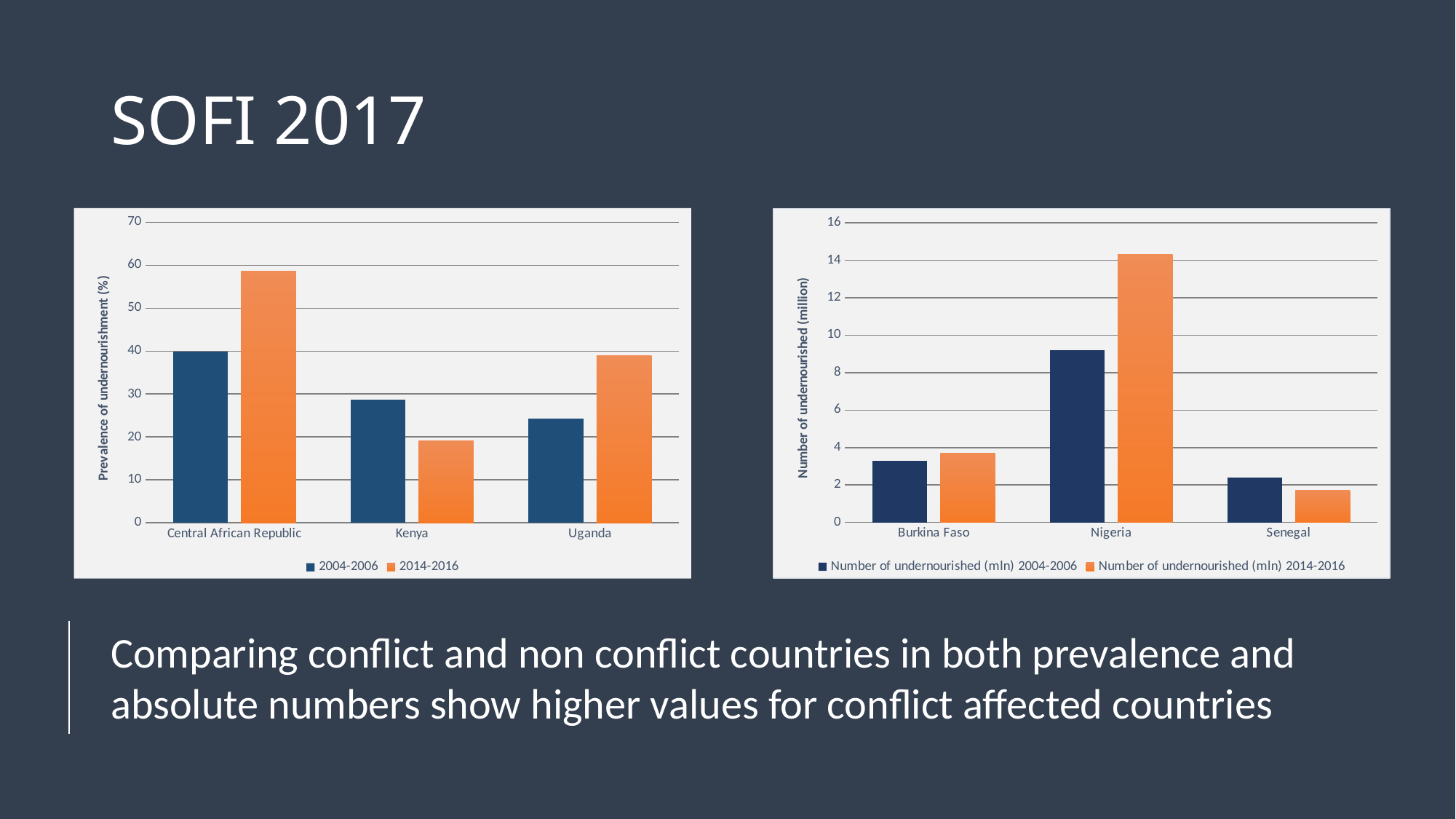
On the left chart (Prevalence of undernourishment), which country has the highest 2014-2016 value? Central African Republic What kind of chart is the left chart (Prevalence of undernourishment)? bar chart On the left chart (Prevalence of undernourishment), which is larger for Kenya: the 2004-2006 value or the 2014-2016 value? 2004-2006 On the right chart (Number of undernourished), which country has the highest 2014-2016 value? Nigeria How many countries are shown on the left chart (Prevalence of undernourishment)? 3 On the right chart (Number of undernourished), is the 2014-2016 value for Nigeria greater or less than 12? greater What is the y-axis label of the right chart? Number of undernourished (million) How many series does the legend of the left chart (Prevalence of undernourishment) list? 2 On the right chart (Number of undernourished), which is larger for Senegal: the 2004-2006 value or the 2014-2016 value? 2004-2006 On the right chart (Number of undernourished), which country has the lowest 2014-2016 value? Senegal On the left chart (Prevalence of undernourishment), which country has the lowest 2014-2016 value? Kenya On the left chart (Prevalence of undernourishment), is the 2014-2016 value for Central African Republic greater or less than 50? greater